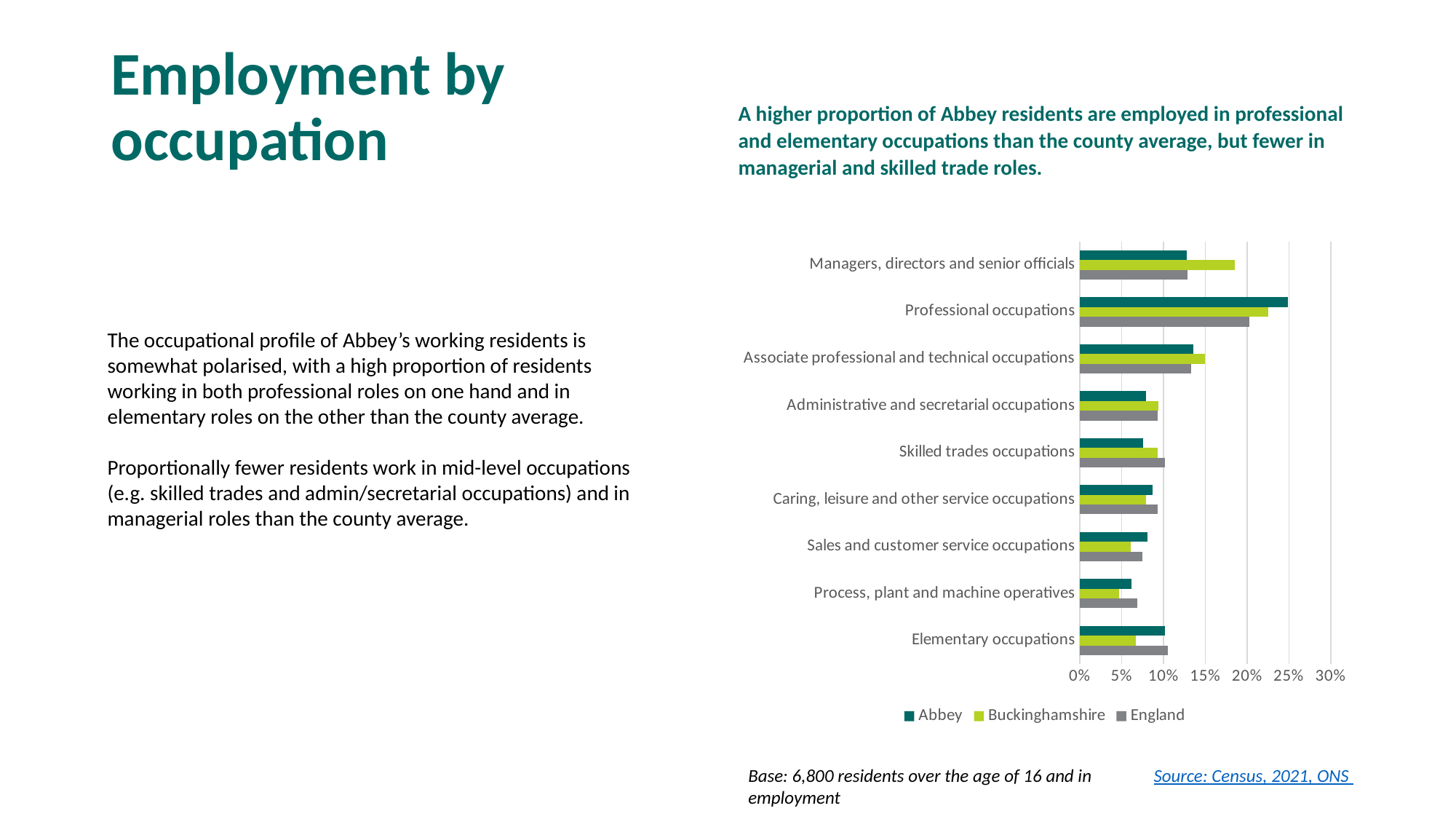
Is the Buckinghamshire value for Managers, directors and senior officials greater or less than 15%? greater Which occupation category has the lowest value for Buckinghamshire? Process, plant and machine operatives How many series does the chart legend list? 3 How many occupation categories are plotted in the chart? 9 Is the Buckinghamshire value for Elementary occupations greater or less than 10%? less Which series is shown in dark teal in the chart legend? Abbey Is the Abbey value for Professional occupations greater or less than 20%? greater What kind of chart is shown on the slide? bar chart For Elementary occupations, which is larger: the Abbey value or the Buckinghamshire value? Abbey For Managers, directors and senior officials, which is larger: the Abbey value or the Buckinghamshire value? Buckinghamshire Which occupation category has the highest value for Abbey? Professional occupations Which occupation category has the highest value for England? Professional occupations